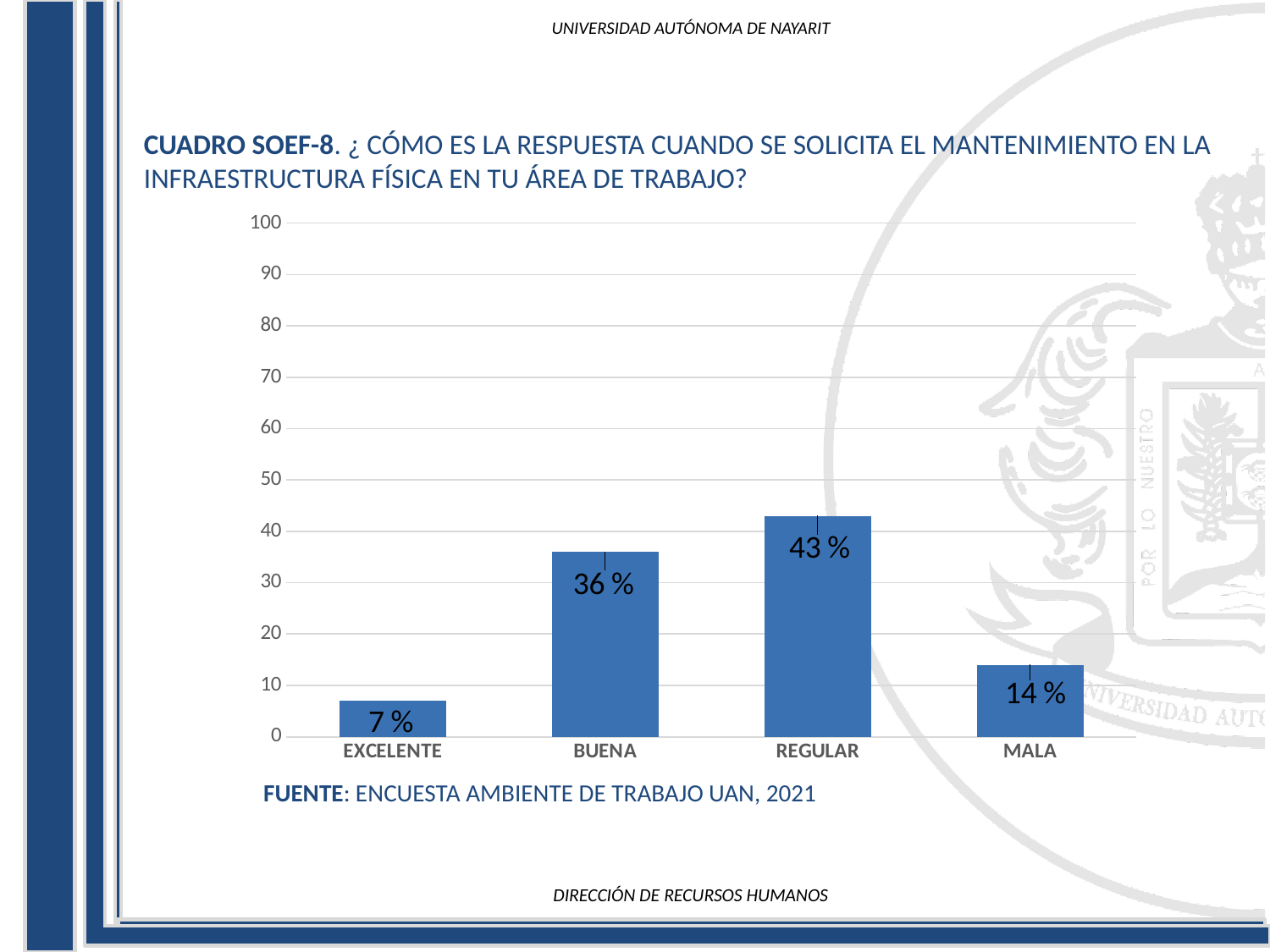
What is the value for MALA? 14 % Which category has the highest value? REGULAR Which is larger, the value for BUENA or the value for MALA? BUENA What is the value for EXCELENTE? 7 % What is the difference between the values for REGULAR and BUENA? 7 % What is the difference between the values for MALA and EXCELENTE? 7 % What kind of chart is shown on the slide? bar chart What is the value for BUENA? 36 % How many categories are shown on the x axis? 4 Which category has the lowest value? EXCELENTE Is the value for REGULAR greater or less than 40? greater What is the value for REGULAR? 43 %